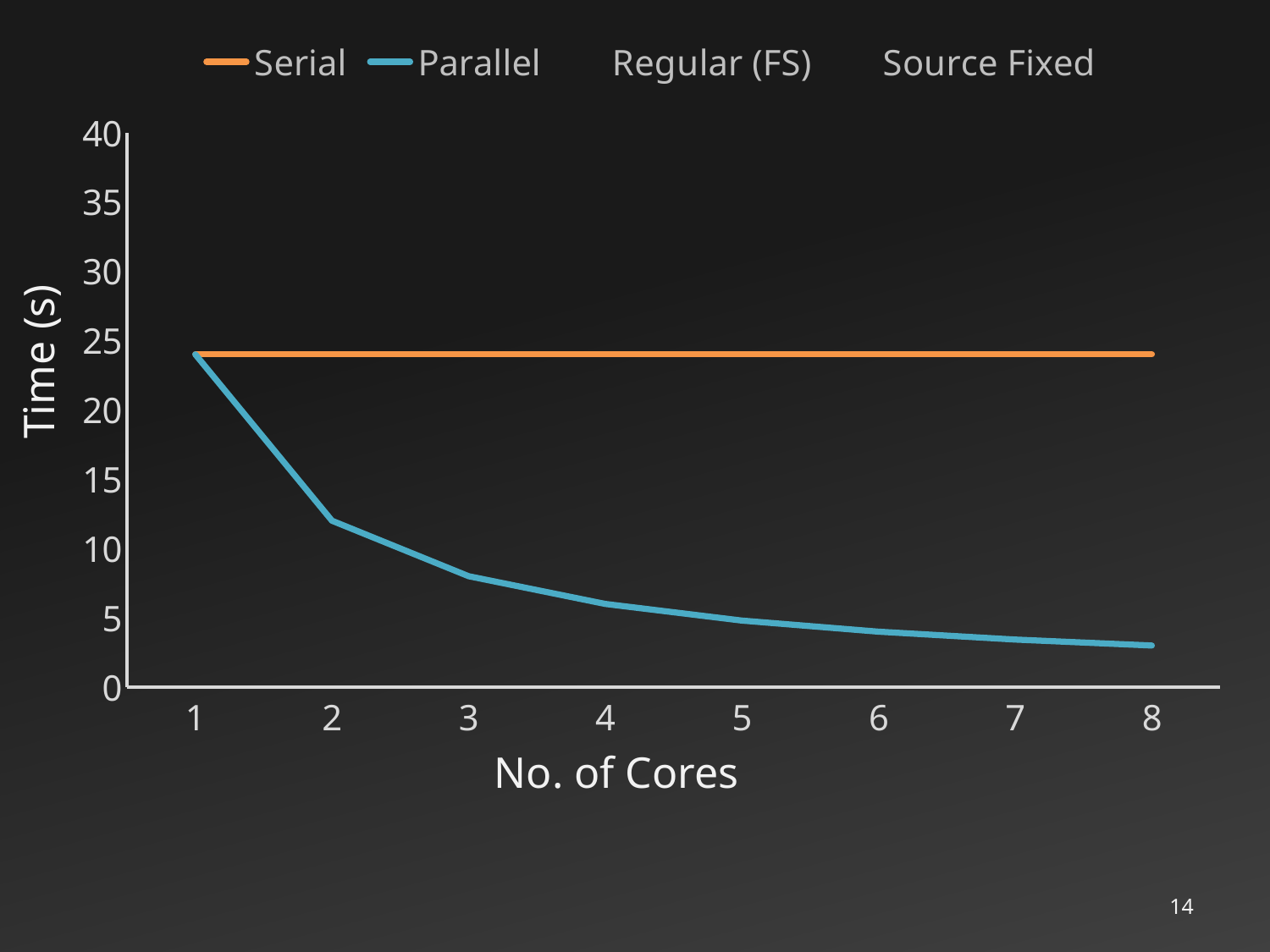
Is the Parallel time at 2 cores greater or less than 15 seconds? less Is the Serial time greater or less than 20 seconds? greater Is the Parallel time at 2 cores greater or less than 10 seconds? greater Does the Parallel series rise or fall as the number of cores increases? fall What is the label of the y axis? Time (s) How many points along the x axis (number of cores) are plotted? 8 At 4 cores, which series has the larger time, Serial or Parallel? Serial What kind of chart is shown on the slide? line chart What is the label of the x axis? No. of Cores Which series is drawn in orange? Serial